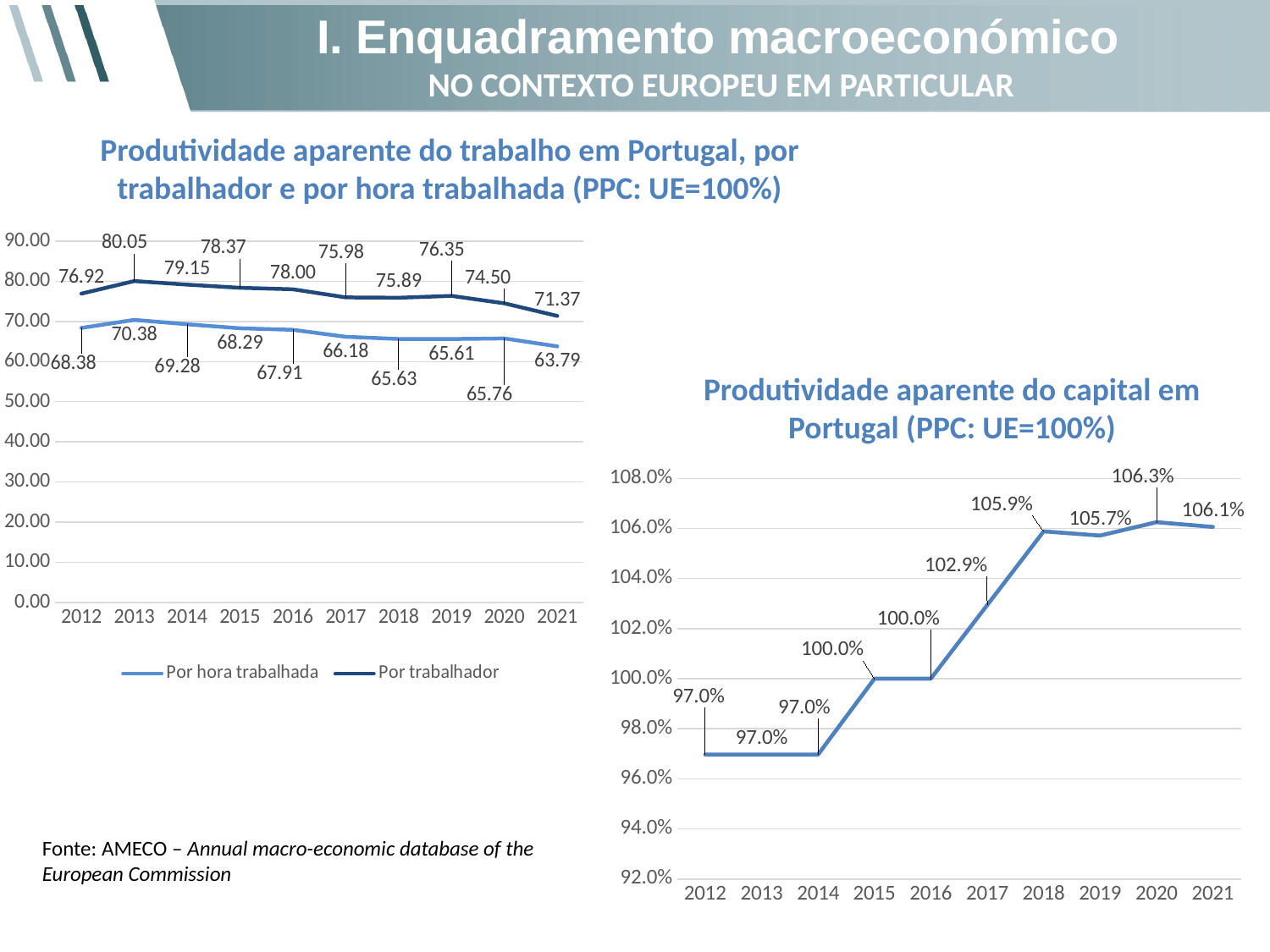
In the chart 'Produtividade aparente do trabalho em Portugal', what is the value for 'Por trabalhador' in 2013? 80.05 In the chart 'Produtividade aparente do capital em Portugal', what is the value for 2017? 102.9% In the chart 'Produtividade aparente do trabalho em Portugal', what is the value for 'Por hora trabalhada' in 2021? 63.79 In the chart 'Produtividade aparente do capital em Portugal', what is the difference between the 2021 value and the 2012 value? 9.1% In the chart 'Produtividade aparente do capital em Portugal', which year has the highest value? 2020 In the chart 'Produtividade aparente do trabalho em Portugal', in which year is the 'Por hora trabalhada' series lowest? 2021 What type of chart is 'Produtividade aparente do capital em Portugal'? Line chart In the chart 'Produtividade aparente do trabalho em Portugal', in which year is the 'Por trabalhador' series highest? 2013 In the chart 'Produtividade aparente do capital em Portugal', how many years are shown on the x axis? 10 In the chart 'Produtividade aparente do trabalho em Portugal', what is the difference between 'Por trabalhador' and 'Por hora trabalhada' in 2012? 8.54 In the chart 'Produtividade aparente do trabalho em Portugal', what is the overall trend of the 'Por trabalhador' series from 2013 to 2021? Falling In the chart 'Produtividade aparente do trabalho em Portugal', how many series does the legend list? 2